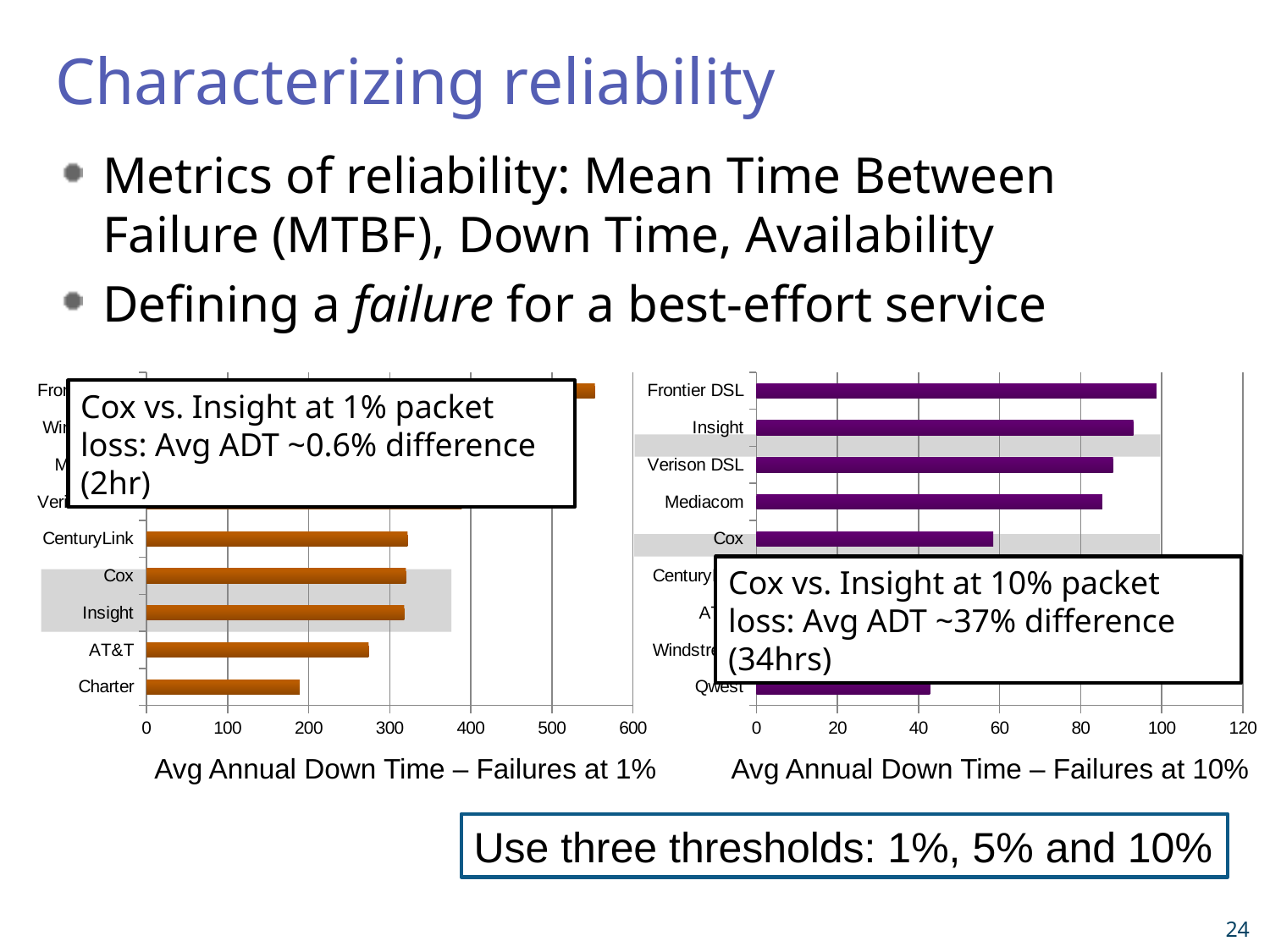
In the chart titled "Avg Annual Down Time – Failures at 10%", is the value for Frontier DSL greater or less than 80? greater What kind of chart is the chart titled "Avg Annual Down Time – Failures at 1%"? bar chart In the chart titled "Avg Annual Down Time – Failures at 1%", which is larger, the value for CenturyLink or the value for Charter? CenturyLink In the chart titled "Avg Annual Down Time – Failures at 1%", is the value for CenturyLink greater or less than 300? greater In the chart titled "Avg Annual Down Time – Failures at 10%", is the value for Qwest greater or less than 60? less In the chart titled "Avg Annual Down Time – Failures at 10%", which is larger, the value for Frontier DSL or the value for Qwest? Frontier DSL In the chart titled "Avg Annual Down Time – Failures at 1%", which is larger, the value for AT&T or the value for Charter? AT&T What is the title of the chart on the right side of the slide? Avg Annual Down Time – Failures at 10%